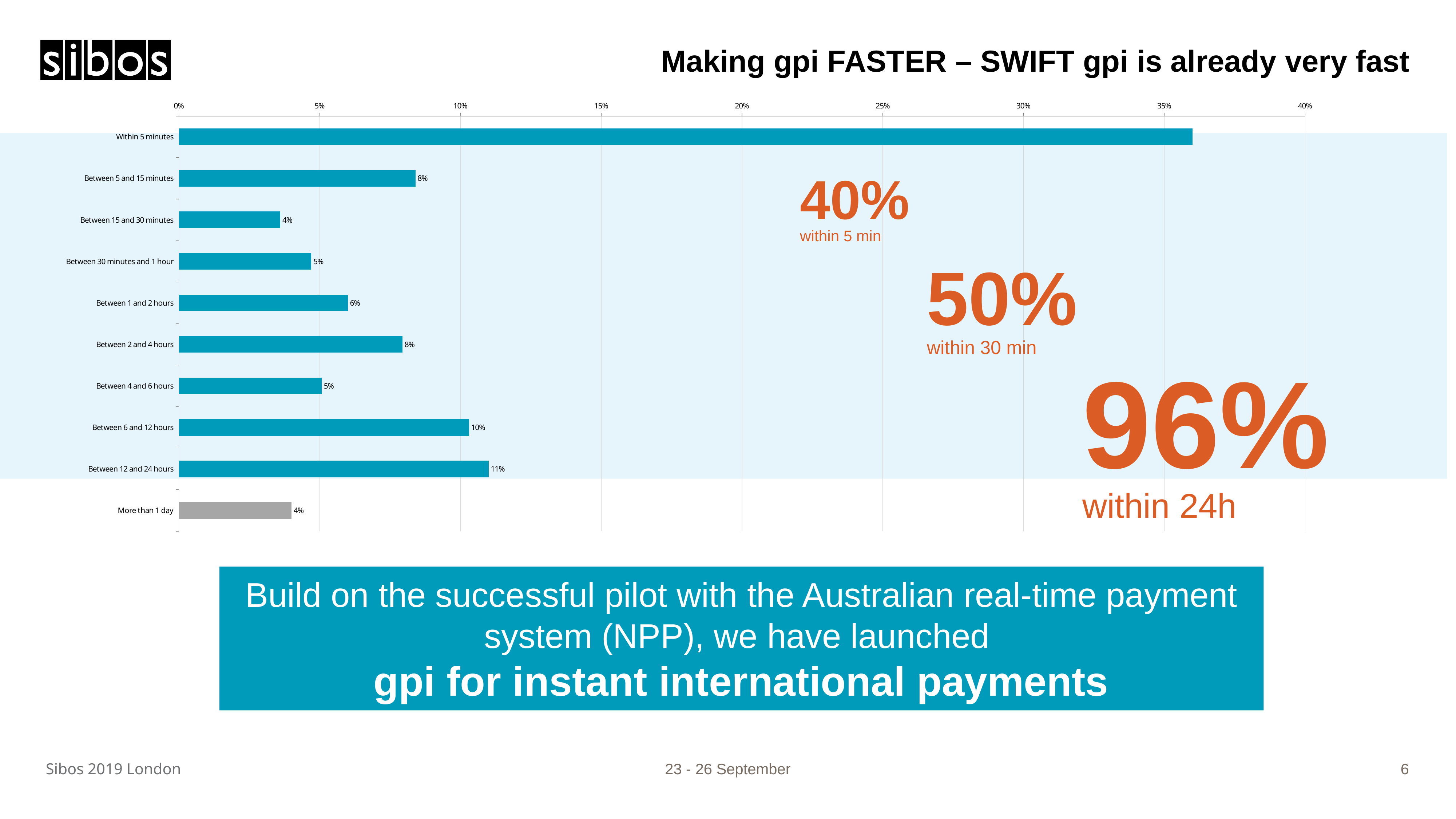
Which is larger: the value for 'Between 6 and 12 hours' or 'Between 2 and 4 hours'? Between 6 and 12 hours Is the value for 'Within 5 minutes' greater or less than 35%? greater Which bar in the chart is coloured grey rather than teal? More than 1 day How many categories are plotted in the chart? 10 What is the value for 'Between 5 and 15 minutes'? 8% What kind of chart is shown on the slide? bar chart Which category has the highest value? Within 5 minutes What is the value for 'Between 1 and 2 hours'? 6% What is the difference between the values for 'Between 12 and 24 hours' and 'Between 2 and 4 hours'? 3% What is the value for 'More than 1 day'? 4% What is the value for 'Between 12 and 24 hours'? 11% What is the value for 'Between 6 and 12 hours'? 10%